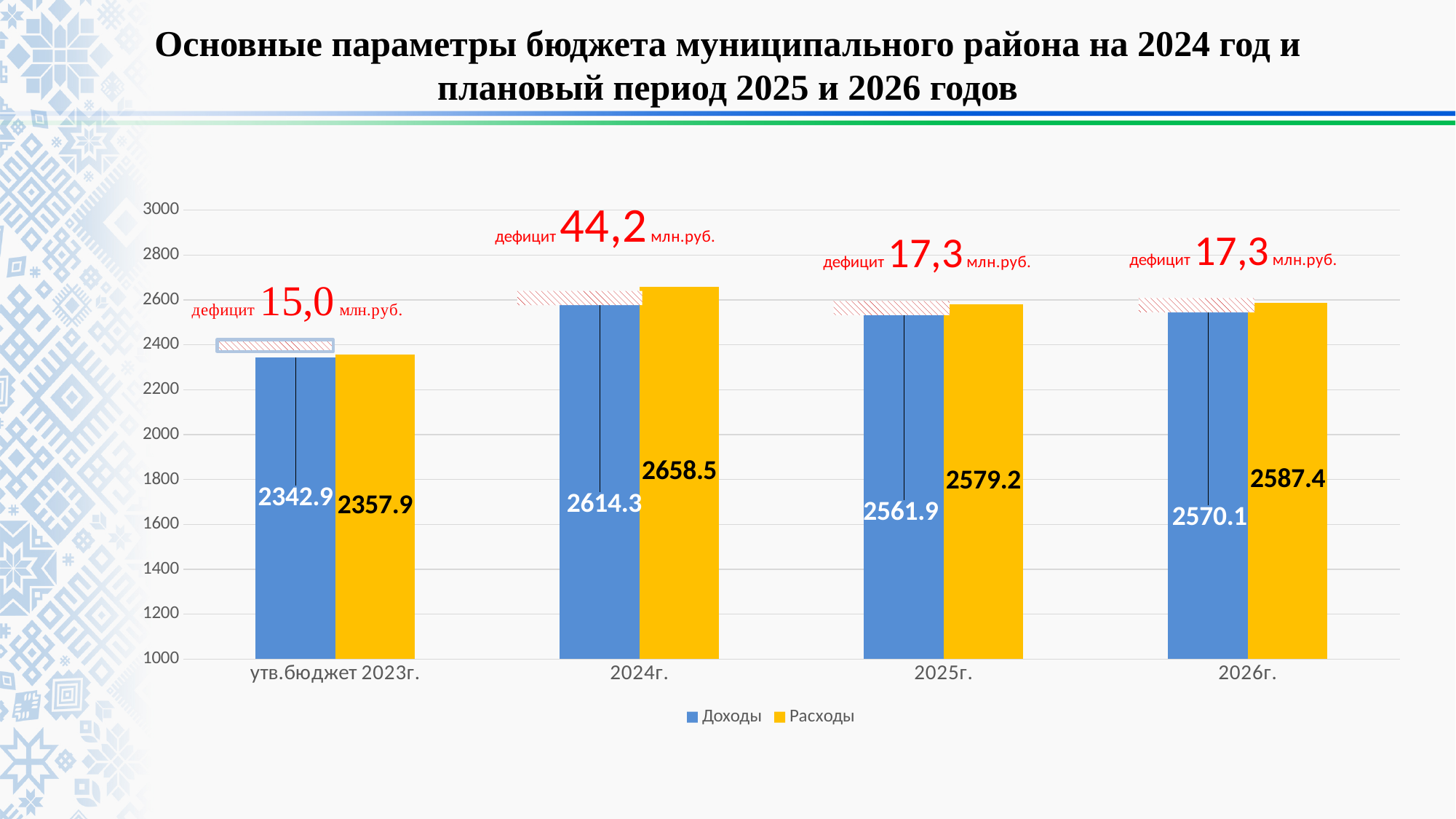
What colour are the Расходы bars? yellow Which category has the lowest value of Доходы? утв.бюджет 2023г. Which is larger for 2025г., Доходы or Расходы? Расходы Which category has the highest value of Расходы? 2024г. How many series does the legend list? 2 What is the value of Расходы for утв.бюджет 2023г.? 2357.9 What is the difference between Расходы and Доходы for 2024г.? 44.2 What kind of chart is shown on the slide? bar chart What is the value of Доходы for 2025г.? 2561.9 How many categories are shown on the x axis? 4 What is the value of Доходы for 2024г.? 2614.3 What is the value of Расходы for 2026г.? 2587.4